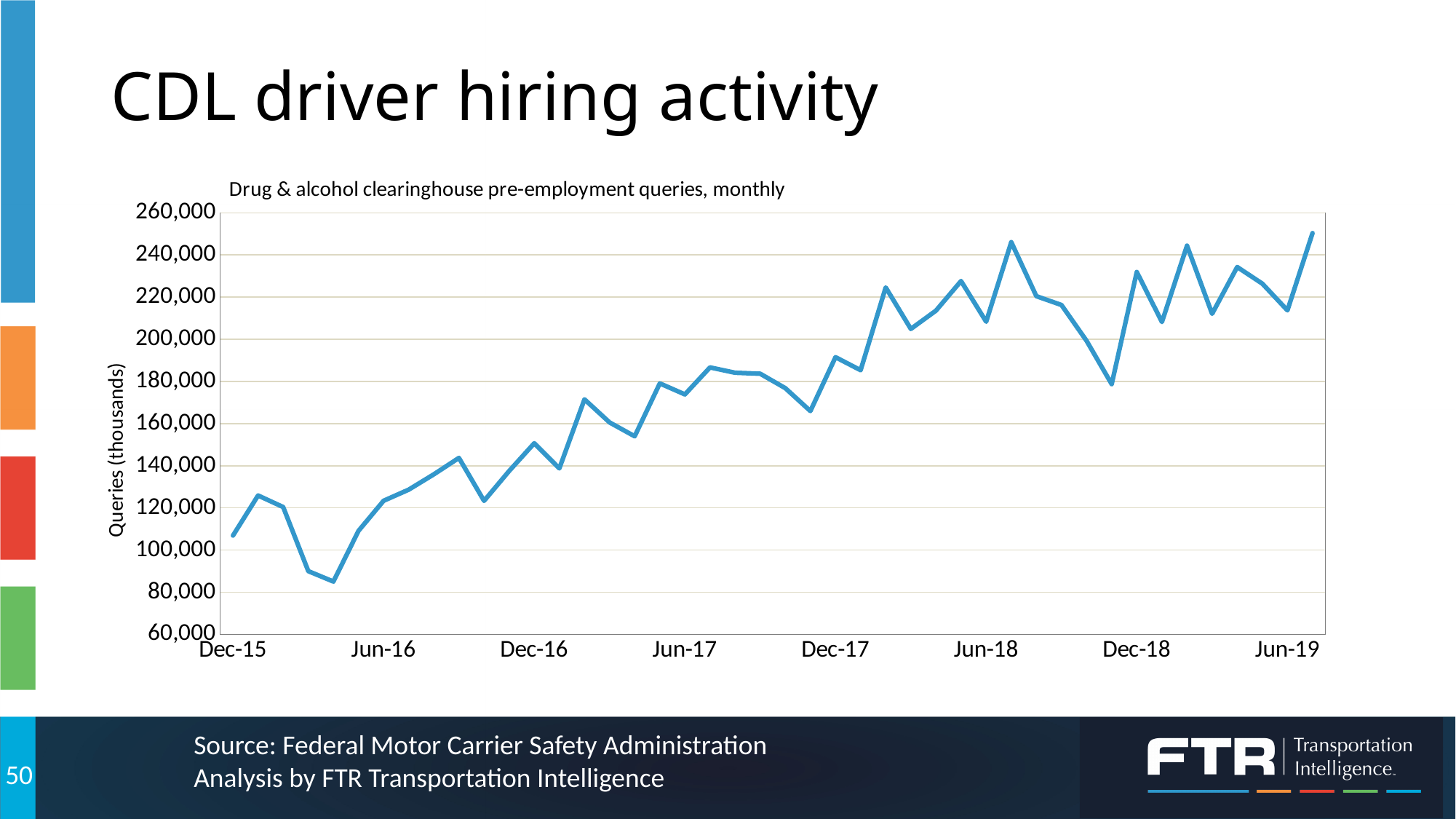
Is the value for Jun-17 greater or less than 200,000? less Is the value for Dec-15 greater or less than 120,000? less Is the value for Dec-16 greater or less than 140,000? greater What kind of chart is shown on the slide? line chart What is the label on the vertical axis of the chart? Queries (thousands) What is the subtitle printed above the chart? Drug & alcohol clearinghouse pre-employment queries, monthly Overall, do the monthly query values rise or fall from Dec-15 to Jun-19? rise Which is larger, the value for Jun-19 or the value for Dec-15? Jun-19